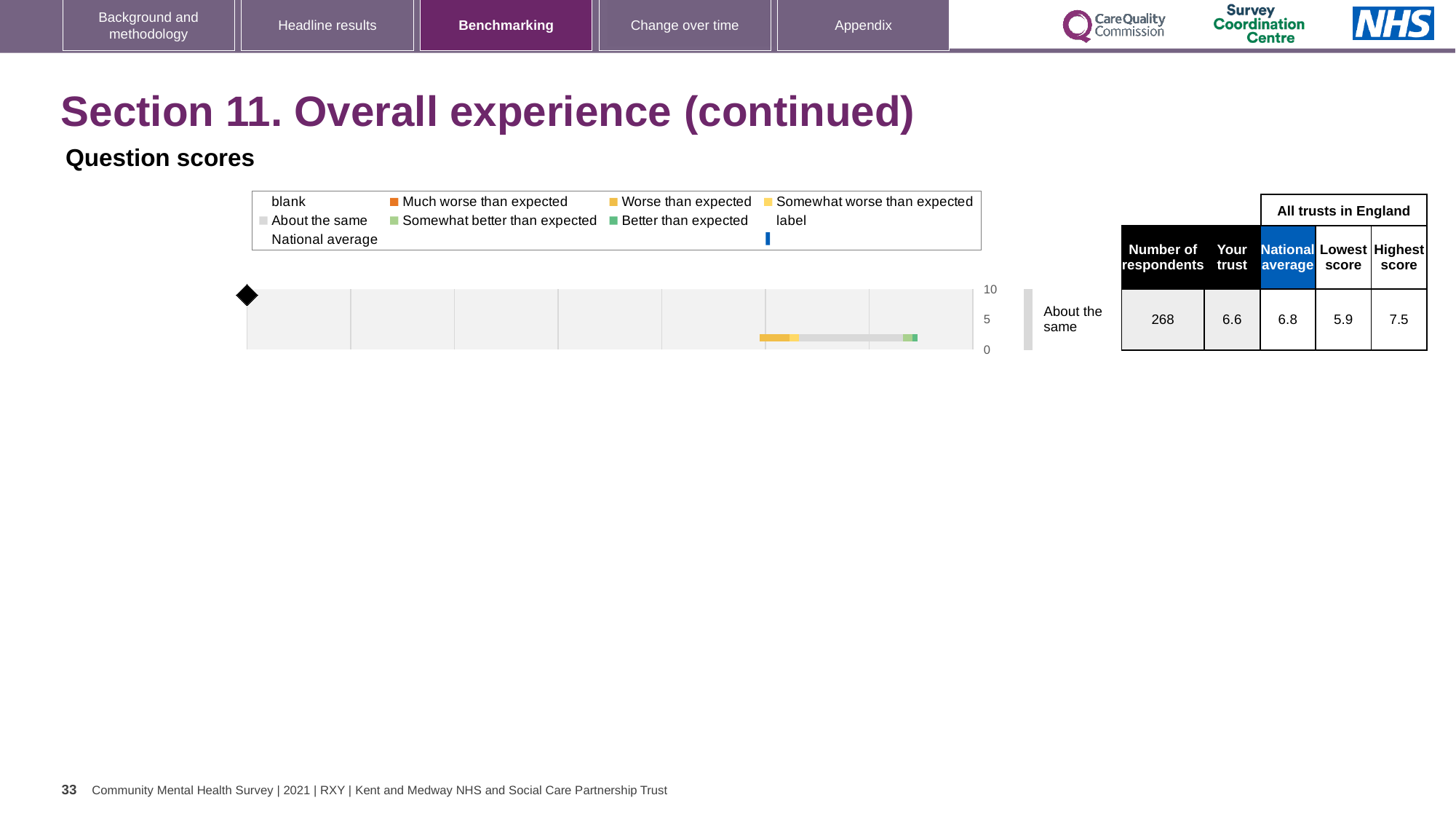
How many question rows (categories) are plotted in the chart? 1 How many respondents answered this question? 268 What is the national average score for this question? 6.8 What kind of chart is shown under 'Question scores'? bar chart What is the difference between the highest score and the lowest score across all trusts in England? 1.6 What is the benchmark category label shown next to the bar? About the same Is the 'Your trust' score greater or less than 5? greater What is the 'Your trust' score for this question? 6.6 What is the lowest score among all trusts in England for this question? 5.9 What is the maximum value shown on the chart's score axis? 10 Which is larger, the 'Your trust' score or the national average? national average What is the highest score among all trusts in England for this question? 7.5